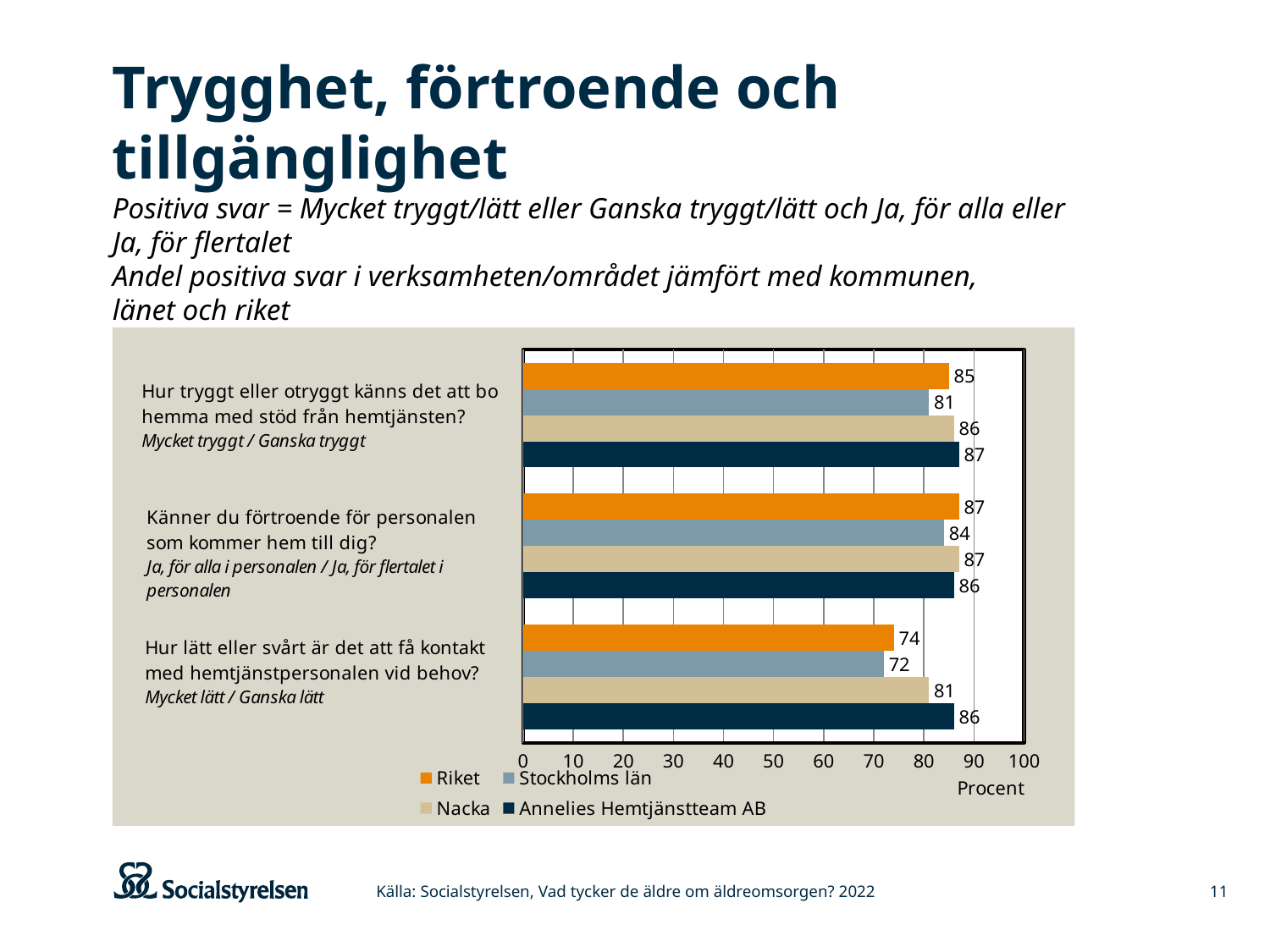
How many question categories are plotted on the chart? 3 How many series does the legend list? 4 Which series has the highest value on the question "Hur tryggt eller otryggt känns det att bo hemma med stöd från hemtjänsten?"? Annelies Hemtjänstteam AB Which series has the lowest value on the question "Hur lätt eller svårt är det att få kontakt med hemtjänstpersonalen vid behov?"? Stockholms län What kind of chart is shown on the slide? Bar chart What is the value for Stockholms län on the question "Hur tryggt eller otryggt känns det att bo hemma med stöd från hemtjänsten?"? 81 What label is shown on the horizontal axis of the chart? Procent What is the value for Riket on the question "Känner du förtroende för personalen som kommer hem till dig?"? 87 What is the value for Annelies Hemtjänstteam AB on the question "Hur lätt eller svårt är det att få kontakt med hemtjänstpersonalen vid behov?"? 86 Is the value for Riket on the question "Hur lätt eller svårt är det att få kontakt med hemtjänstpersonalen vid behov?" greater or less than 80? less What is the difference between Annelies Hemtjänstteam AB and Riket on the question "Hur lätt eller svårt är det att få kontakt med hemtjänstpersonalen vid behov?"? 12 Which is larger on the question "Känner du förtroende för personalen som kommer hem till dig?": Nacka or Stockholms län? Nacka